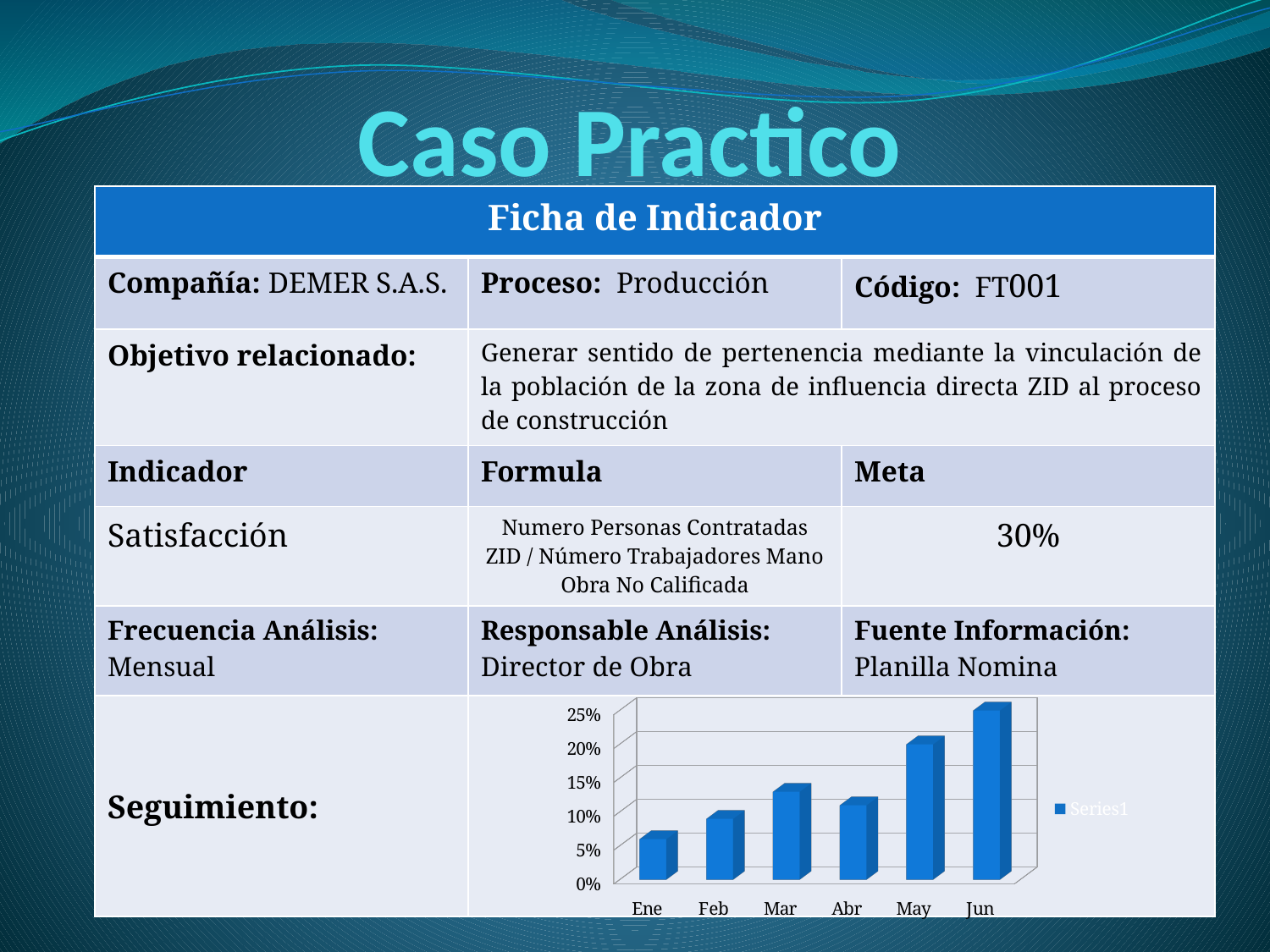
Is the value for Jun greater or less than 20%? greater How many months are plotted on the chart? 6 Which is larger, the value for Mar or the value for Abr? Mar Which month has the lowest bar on the chart? Ene How many series does the chart legend list? 1 What is the name of the series shown in the chart legend? Series1 Is the value for Ene greater or less than 10%? less Is the value for May greater or less than 15%? greater Which month has the highest bar on the chart? Jun What kind of chart is shown in the Seguimiento section? bar chart Which is larger, the value for May or the value for Jun? Jun